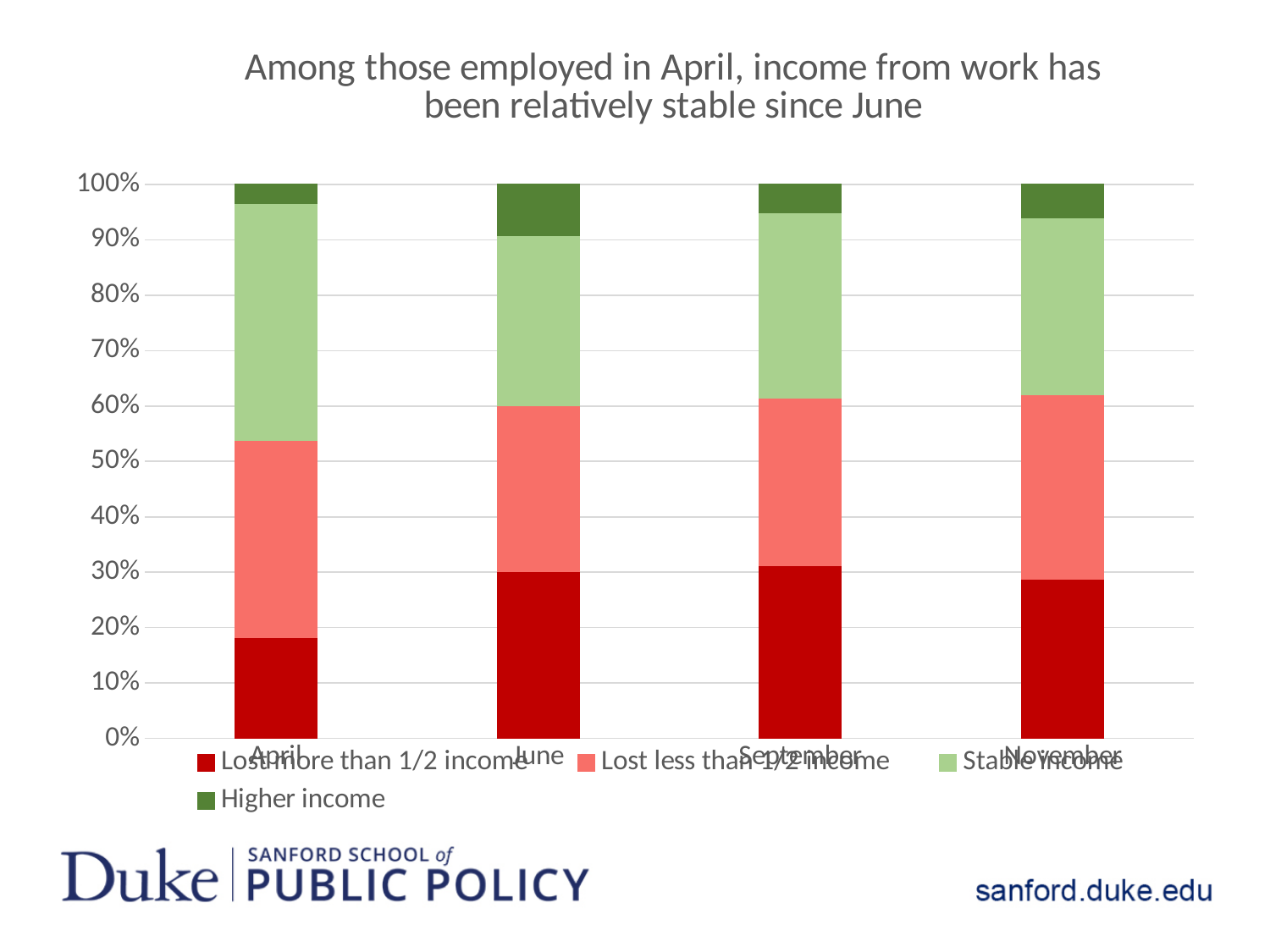
Does the 'Lost more than 1/2 income' share rise or fall from April to June? rise Which is larger, the 'Lost more than 1/2 income' share in April or in June? June Which month has the largest 'Stable income' segment? April What colour represents 'Higher income' in the chart? Dark green Is the 'Lost more than 1/2 income' share in June greater or less than 20%? greater Which month has the smallest 'Lost more than 1/2 income' segment? April How many series does the legend list? 4 What kind of chart is shown on the slide? Stacked bar chart Which month has the largest 'Higher income' segment? June Is the 'Lost more than 1/2 income' share in April greater or less than 10%? greater How many months are shown along the x axis? 4 Is the 'Higher income' share in June greater or less than 20%? less